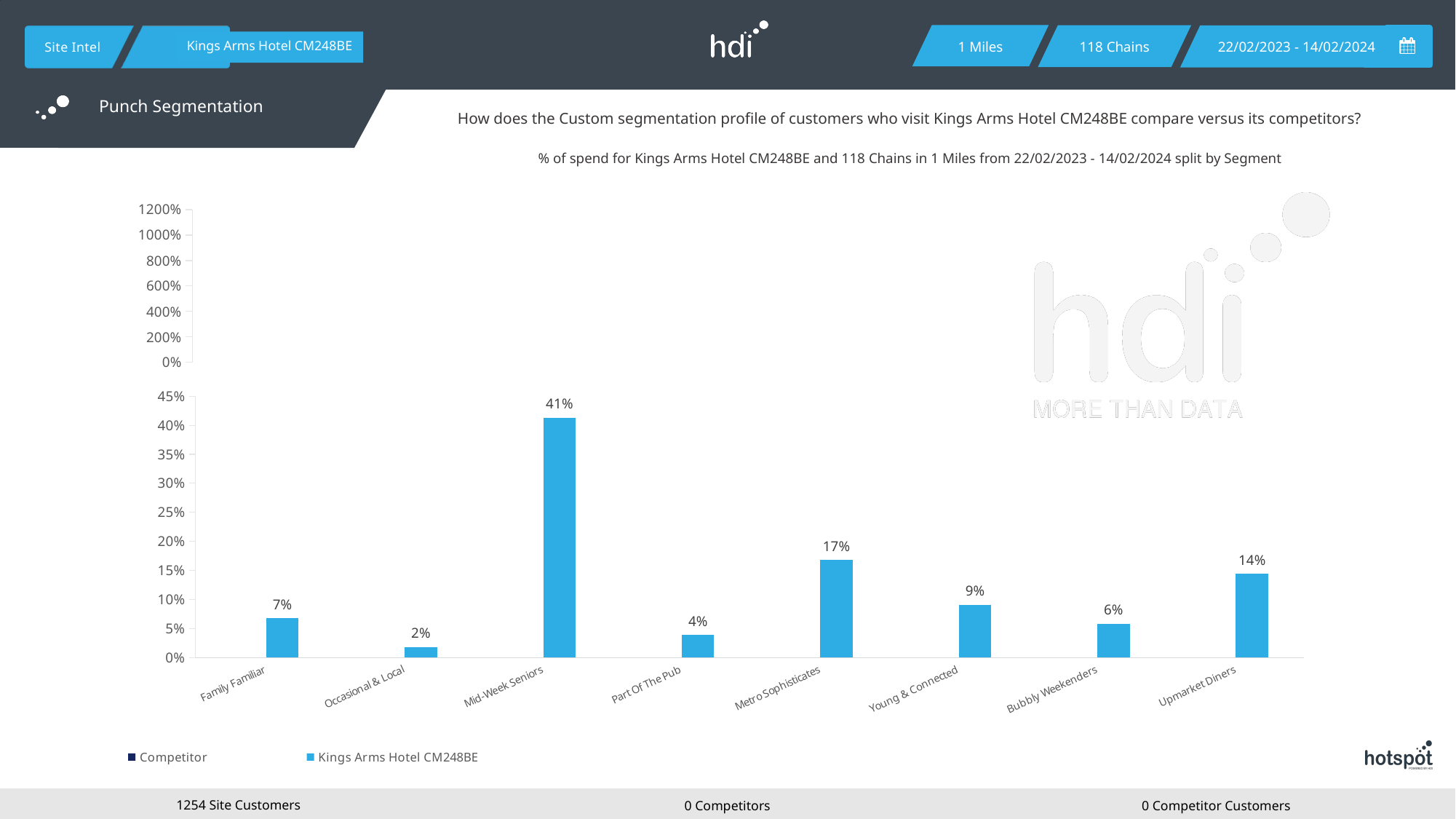
What are the two series named in the legend? Competitor and Kings Arms Hotel CM248BE Which segment has the lowest % of spend for Kings Arms Hotel CM248BE? Occasional & Local What is the difference between the Mid-Week Seniors value and the Metro Sophisticates value? 24% What is the value for Metro Sophisticates for Kings Arms Hotel CM248BE? 17% How many series does the legend list? 2 What is the value for Mid-Week Seniors for Kings Arms Hotel CM248BE? 41% What kind of chart is used to show the % of spend by segment? Bar chart Which is larger for Kings Arms Hotel CM248BE: Young & Connected or Bubbly Weekenders? Young & Connected What is the value for Upmarket Diners for Kings Arms Hotel CM248BE? 14% Which segment has the highest % of spend for Kings Arms Hotel CM248BE? Mid-Week Seniors Is the value for Upmarket Diners greater or less than 10%? greater How many segments are shown on the x axis of the chart? 8